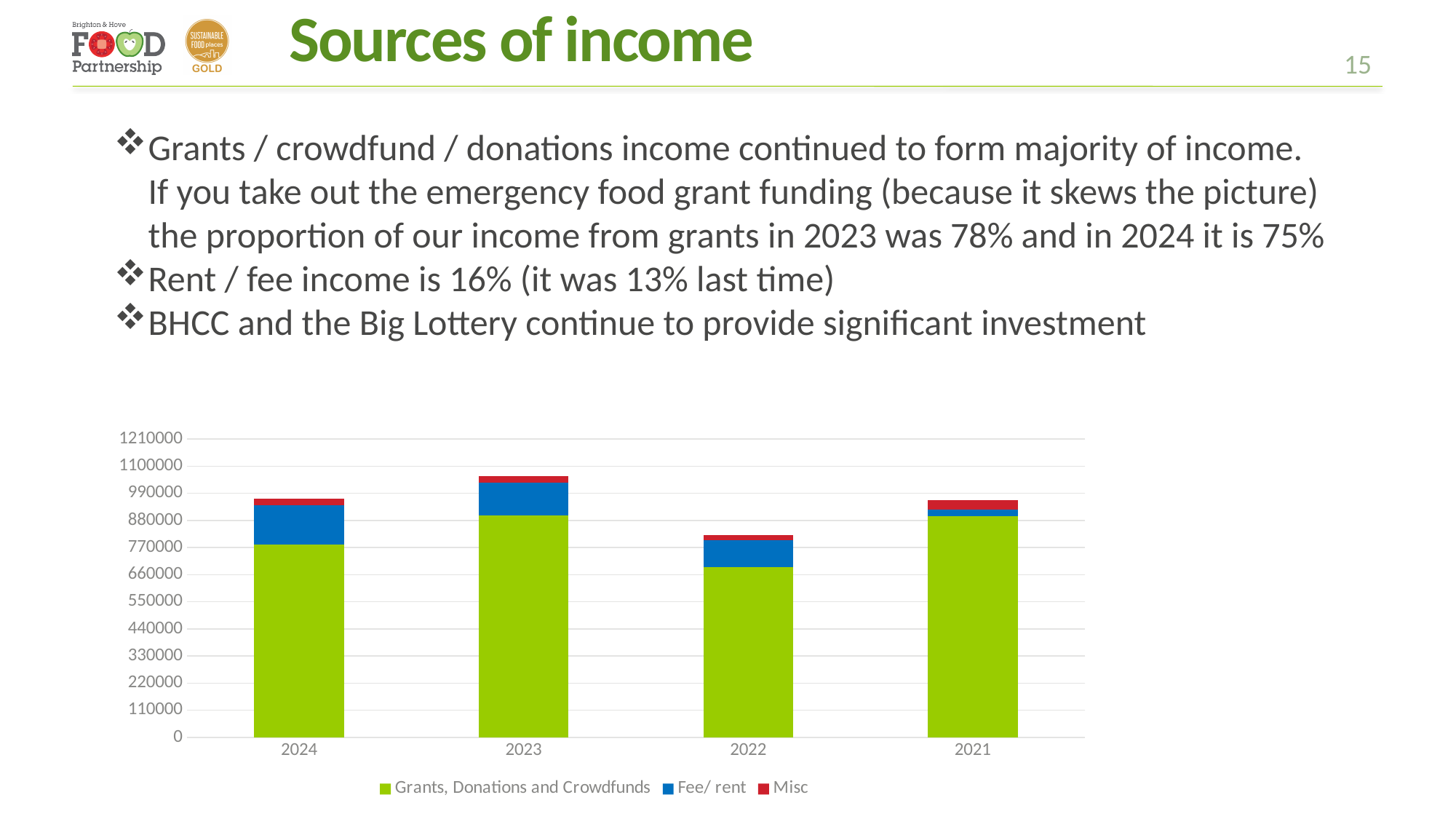
Which year has the lowest total income bar? 2022 Which year has the smallest Grants, Donations and Crowdfunds segment? 2022 Which year has the highest total income bar? 2023 Is the Grants, Donations and Crowdfunds segment for 2024 greater or less than 880000? less Is the total income bar for 2022 greater or less than 880000? less Which series is shown in red in the chart? Misc What kind of chart is shown on the slide? Stacked bar chart Is the Fee/ rent segment larger in 2023 or in 2021? 2023 How many series does the chart legend list? 3 How many years are shown on the x axis of the chart? 4 Is the total income bar for 2023 greater or less than 990000? greater Which series is shown in green in the chart? Grants, Donations and Crowdfunds